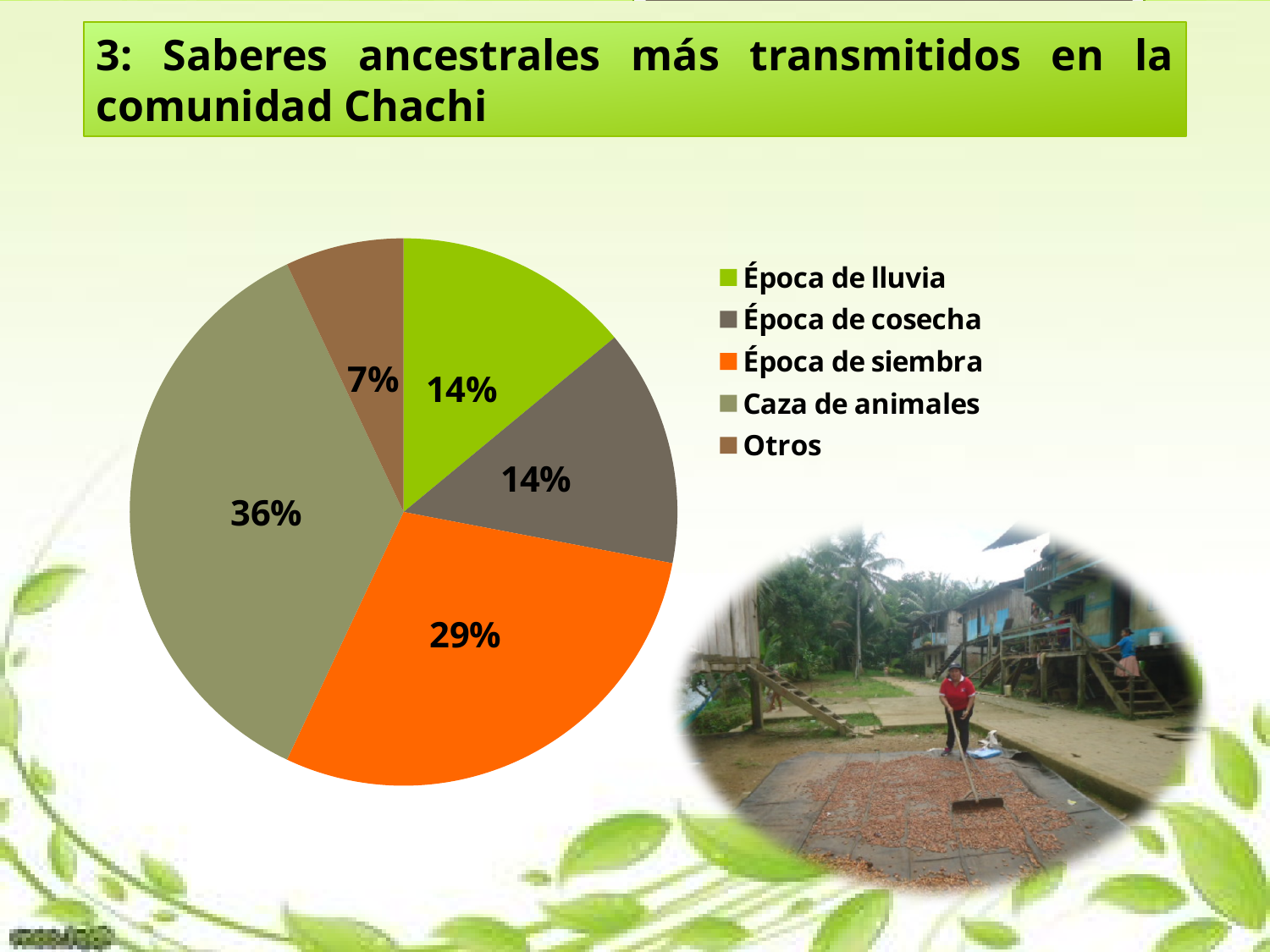
What share of the pie does Otros have? 7% Which legend entry is listed first? Época de lluvia Which category has the smallest slice of the pie? Otros What share of the pie does Época de lluvia have? 14% How many categories does the pie chart show? 5 What kind of chart is shown on the slide? Pie chart What colour is the slice for Época de siembra? Orange What share of the pie does Caza de animales have? 36% What is the difference between the shares of Caza de animales and Época de siembra? 7% Which is larger, the share for Época de siembra or the share for Época de cosecha? Época de siembra Which category has the largest slice of the pie? Caza de animales